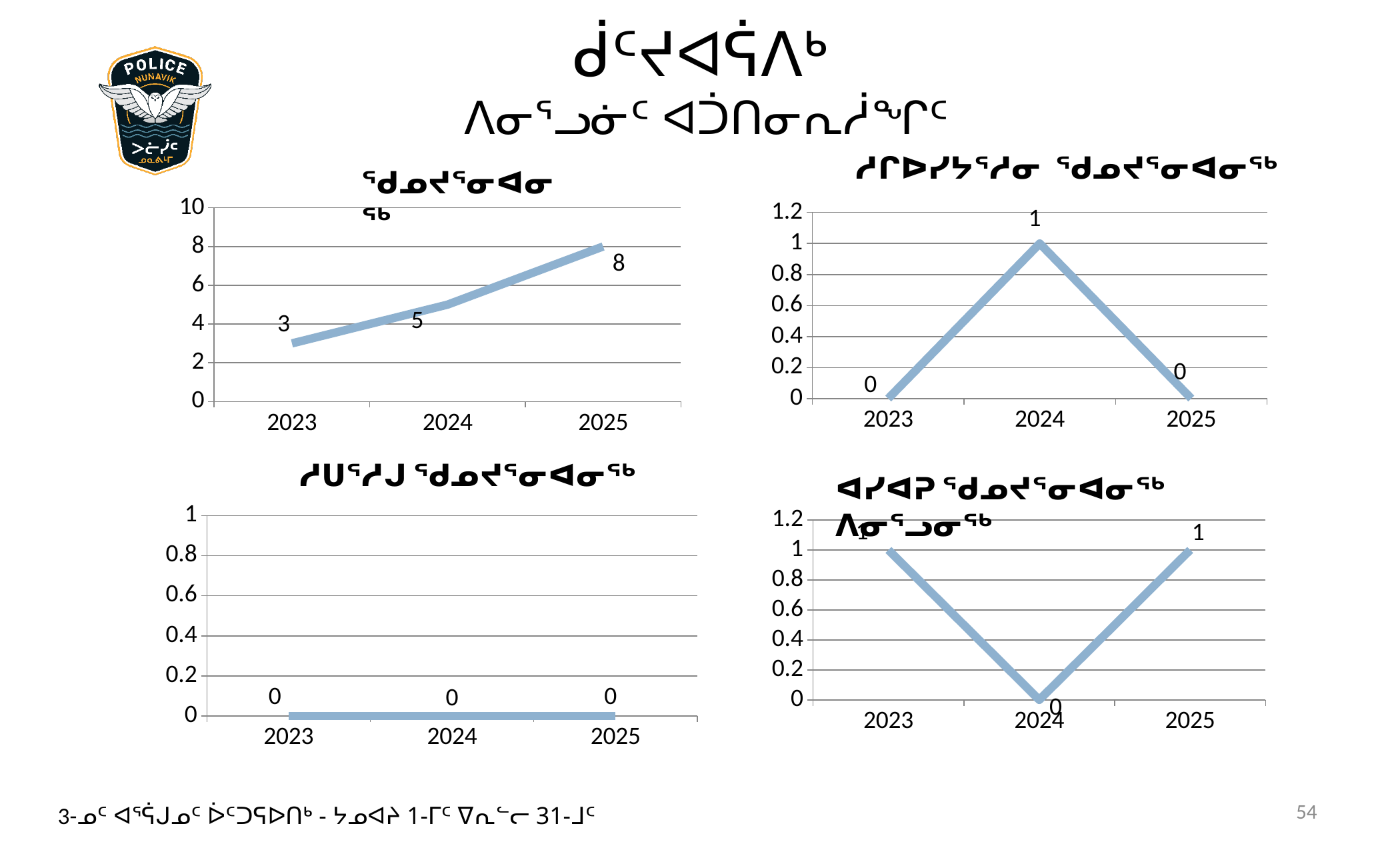
In the top-left chart, what is the value for 2025? 8 In the top-left chart, what is the value for 2023? 3 In the top-left chart, which year has the highest value? 2025 In the bottom-left chart, what is the value for 2025? 0 In the bottom-right chart, which is larger, the value for 2025 or the value for 2024? 2025 In the top-right chart, which year has the highest value? 2024 In the top-left chart, do the values rise or fall from 2023 to 2025? rise In the bottom-right chart, what is the value for 2024? 0 How many charts are on the slide, and what type are they? 4 line charts In the top-left chart, what is the difference between the values for 2025 and 2024? 3 In the top-left chart, is the value for 2024 greater or less than 4? greater In the top-right chart, what is the value for 2024? 1